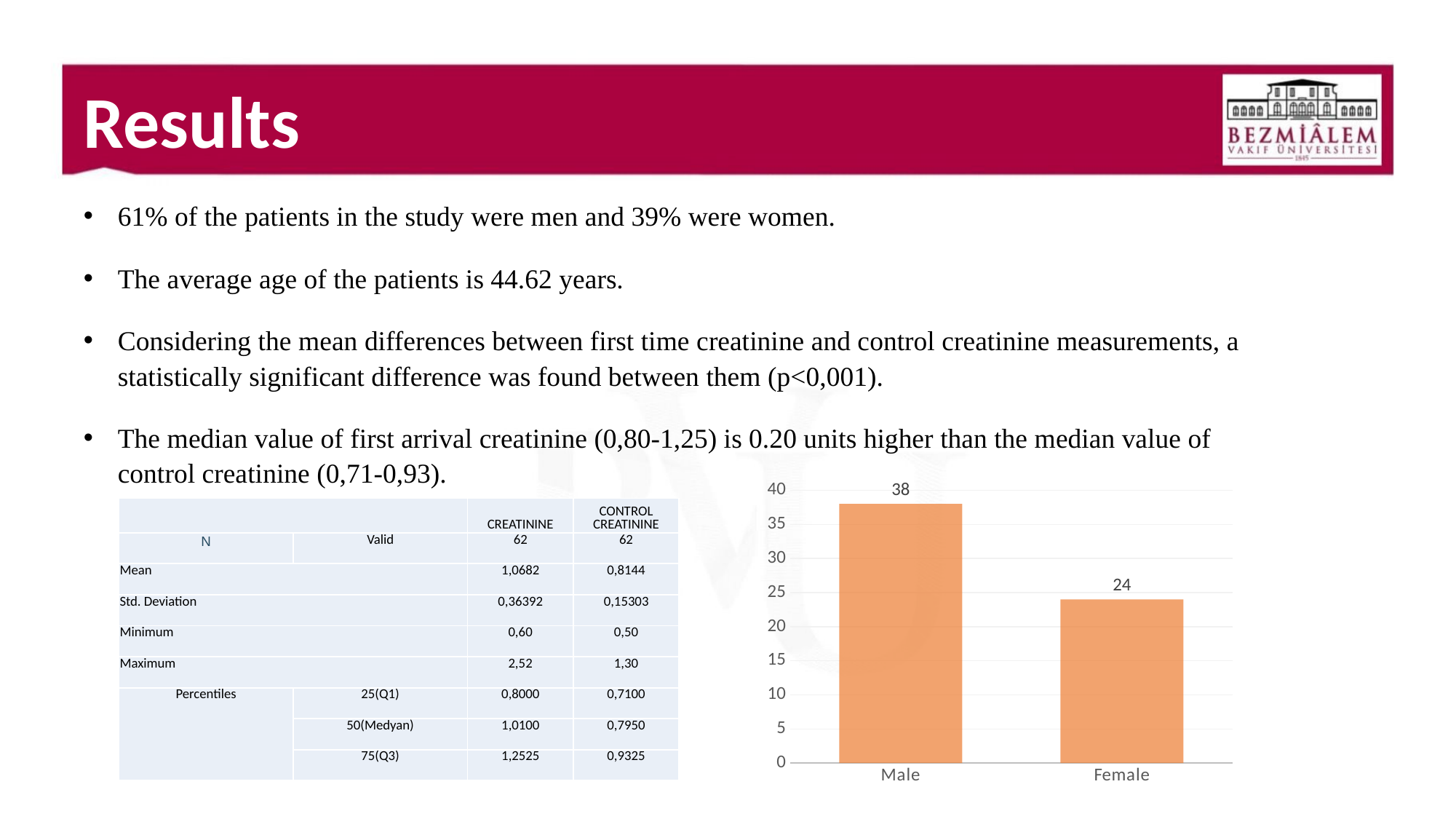
What is the value for Female in the bar chart? 24 Is the value for Female in the bar chart greater or less than 30? less What is the maximum value shown on the vertical axis of the bar chart? 40 How many categories are shown in the bar chart? 2 What is the difference between the Male and Female values in the bar chart? 14 What is the value for Male in the bar chart? 38 Which category has the highest value in the bar chart? Male What kind of chart is shown on the slide? bar chart Which category has the lowest value in the bar chart? Female What is the total of the Male and Female values in the bar chart? 62 Is the value for Male in the bar chart greater or less than 35? greater Which is larger in the bar chart, the value for Male or the value for Female? Male